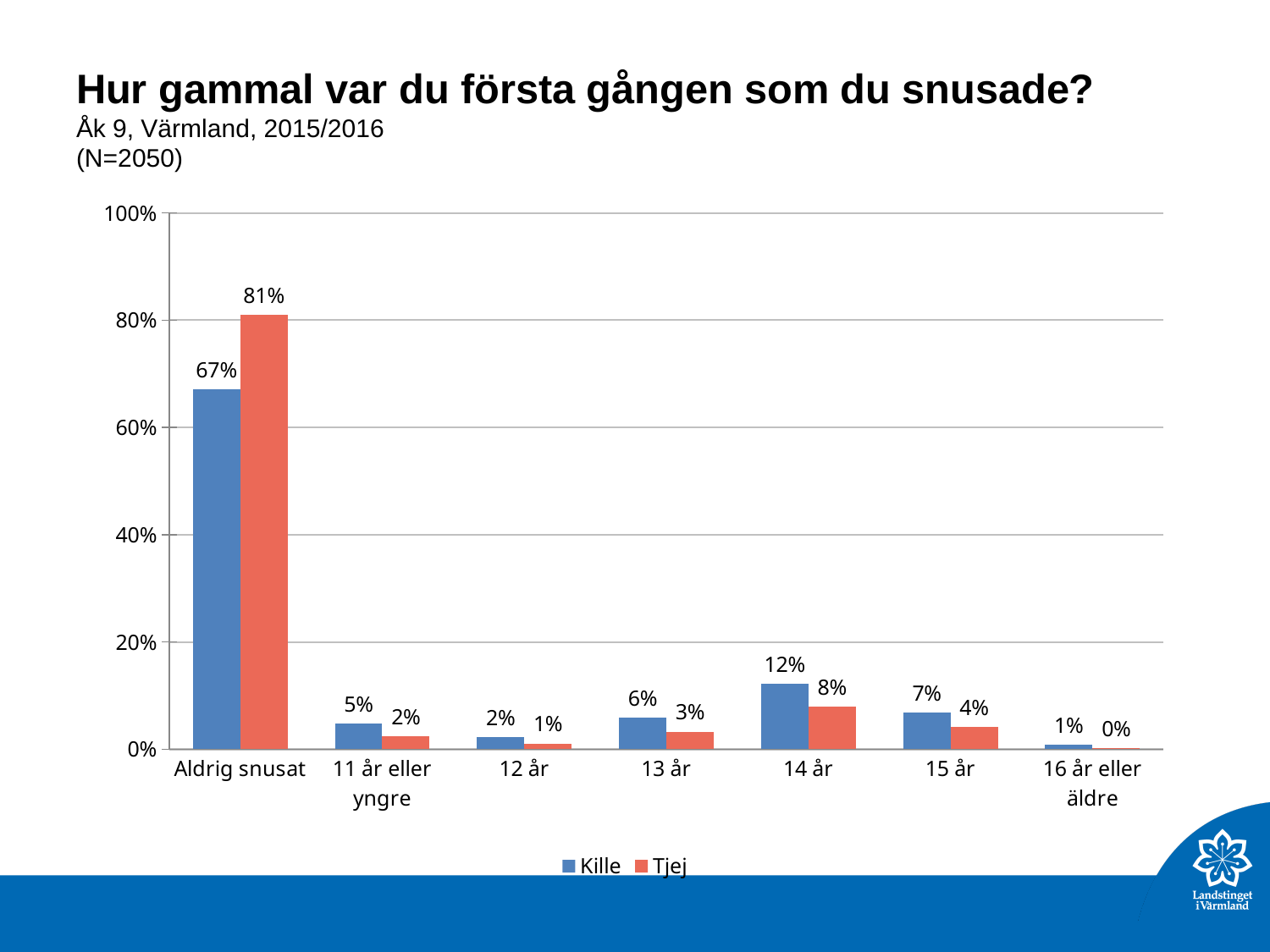
What is the value for Tjej in the 'Aldrig snusat' category? 81% How many categories are shown on the x axis? 7 At '14 år', which series has the larger value, Kille or Tjej? Kille What kind of chart is shown on the slide? Bar chart Is the value for Kille in 'Aldrig snusat' greater or less than 60%? greater What is the difference between the Tjej and Kille values for 'Aldrig snusat'? 14% Which category has the lowest value for Tjej? 16 år eller äldre What is the value for Kille in the 'Aldrig snusat' category? 67% What is the value for Kille at '14 år'? 12% How many series does the legend list? 2 What is the value for Tjej at '15 år'? 4% Which category has the highest value for Tjej? Aldrig snusat